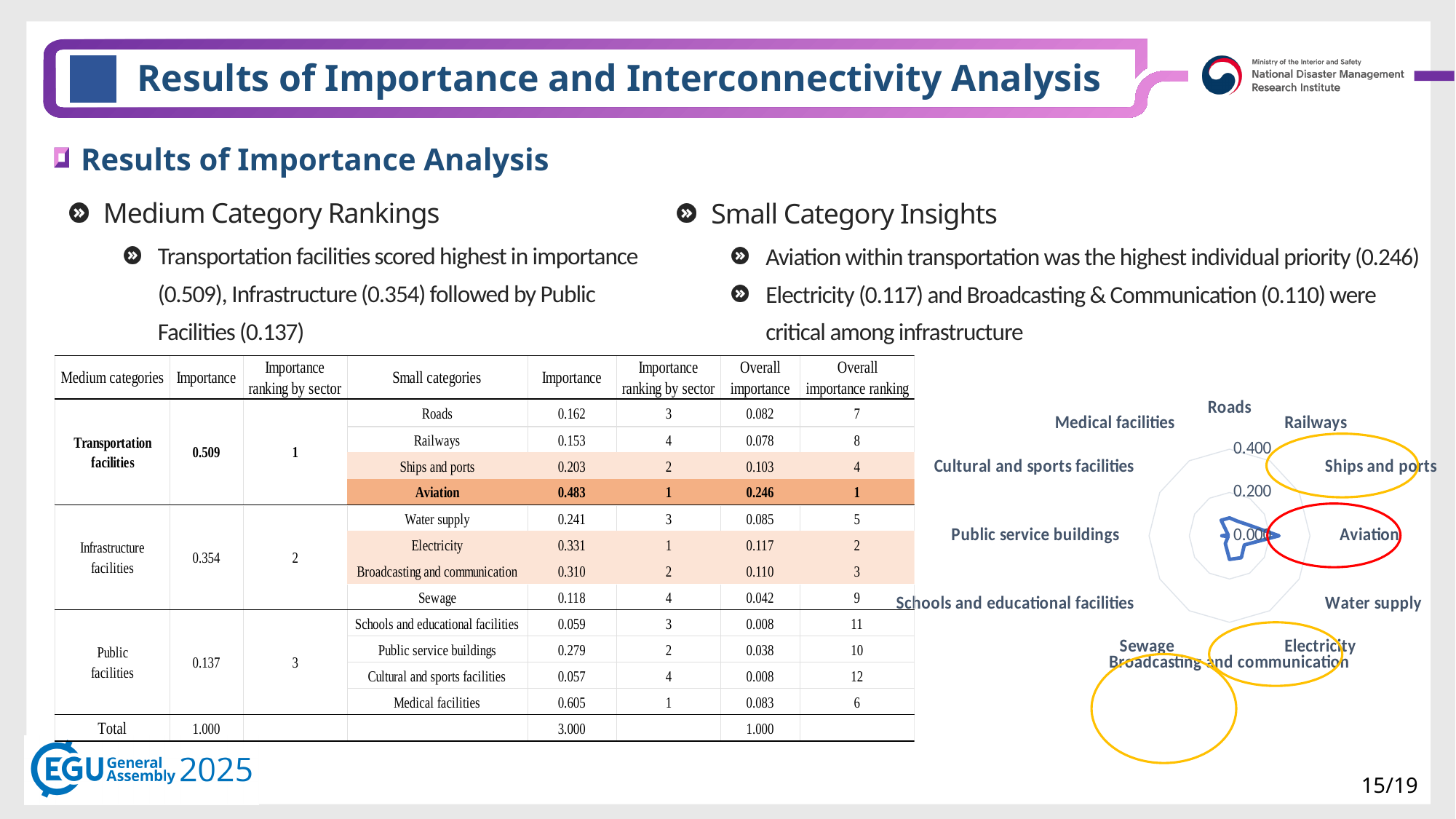
How many categories are plotted on the radar chart? 12 Which category on the radar chart is circled in red? Aviation What kind of chart is shown on the right side of the slide? radar chart What is the highest tick label shown on the radar chart's axis? 0.400 On the radar chart, is the value for Medical facilities greater or less than 0.200? less On the radar chart, is the value for Roads greater or less than 0.200? less On the radar chart, which is larger: the value for Aviation or the value for Schools and educational facilities? Aviation On the radar chart, is the value for Electricity greater or less than 0.200? less Which category has the highest value on the radar chart? Aviation